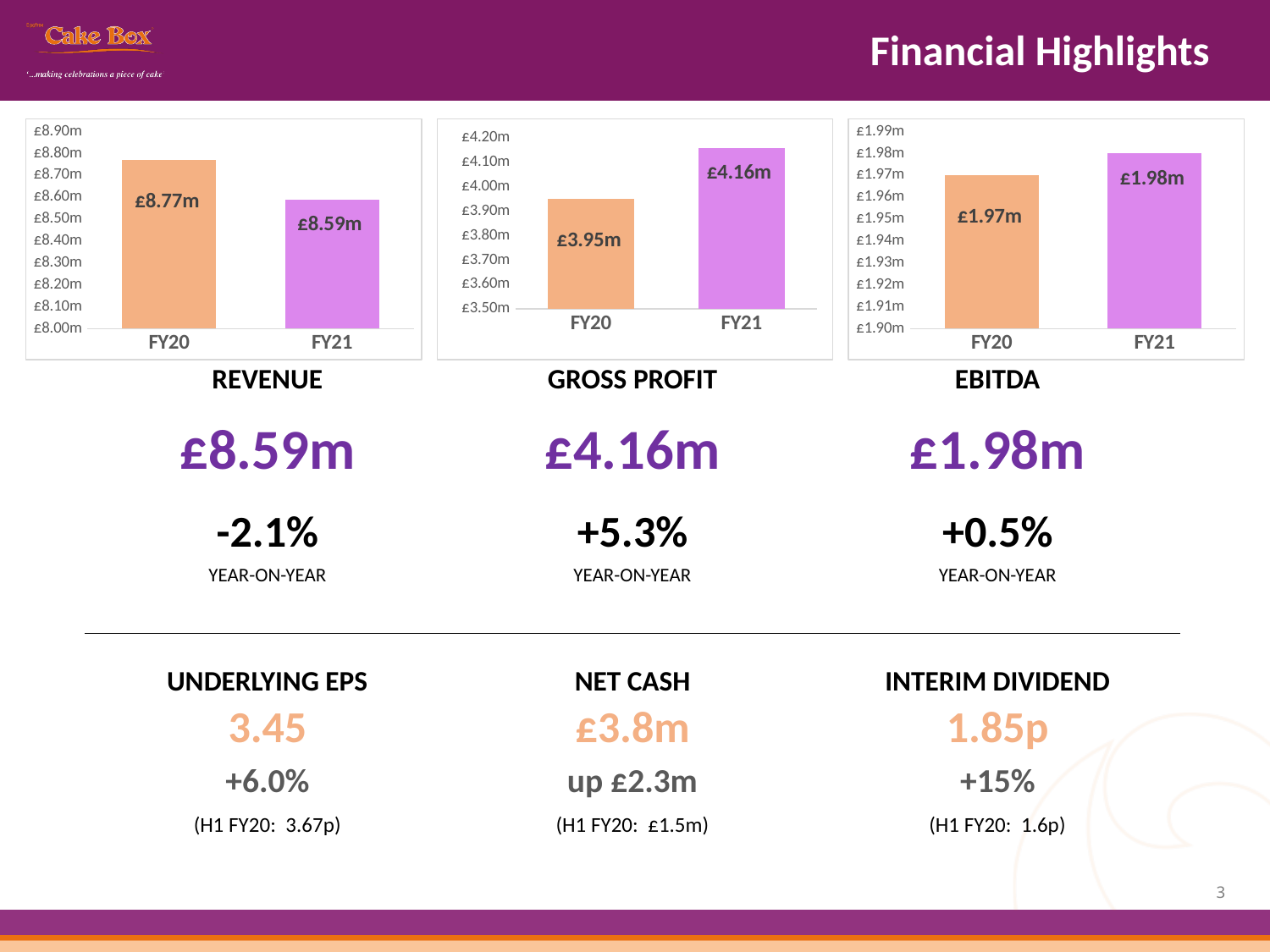
In the Revenue chart (left), which year has the higher value? FY20 In the Revenue chart (left), what is the difference between the FY20 and FY21 values? £0.18m In the Revenue chart (left), what is the value for FY21? £8.59m How many bars are shown in the Revenue chart (left)? 2 In the Gross Profit chart (middle), which year has the lower value? FY20 In the EBITDA chart (right), what is the value for FY21? £1.98m In the Gross Profit chart (middle), what is the value for FY20? £3.95m In the Revenue chart (left), what is the value for FY20? £8.77m In the Gross Profit chart (middle), what is the difference between the FY21 and FY20 values? £0.21m In the Gross Profit chart (middle), is the value for FY21 greater or less than £4.00m? greater What type of chart is the EBITDA chart (right)? bar chart In the EBITDA chart (right), is the FY21 value larger or smaller than the FY20 value? larger